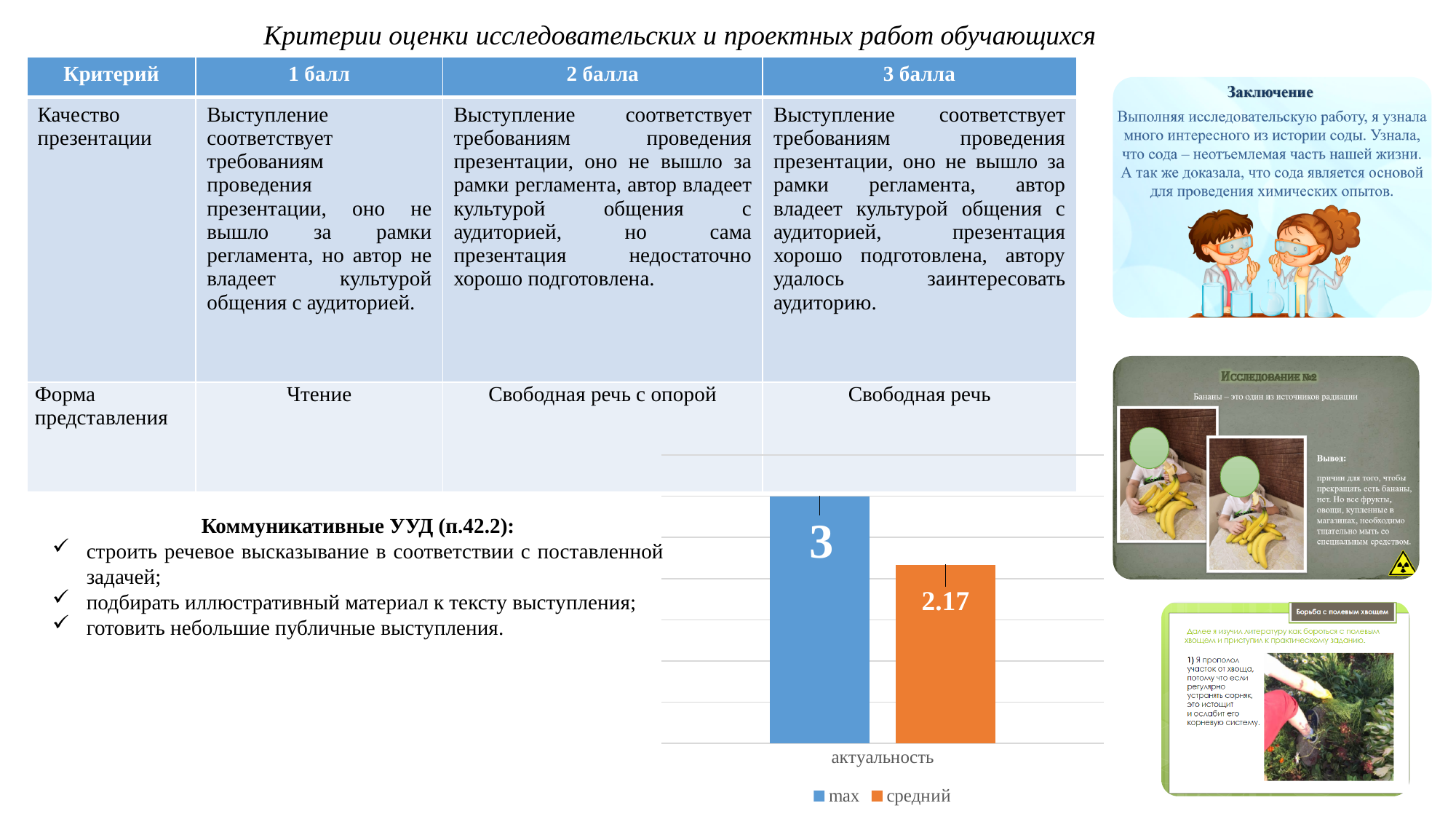
Which series has the higher value for 'актуальность' in the chart? max What is the value of the 'max' series for 'актуальность' in the chart? 3 What kind of chart is shown on the slide? bar chart What colour is the bar for the 'средний' series in the chart? orange What is the category label shown on the x axis of the chart? актуальность How many categories are shown on the x axis of the chart? 1 What is the difference between the 'max' and 'средний' values for 'актуальность'? 0.83 What is the value of the 'средний' series for 'актуальность' in the chart? 2.17 Which series has the lowest value in the chart? средний How many series does the chart legend list? 2